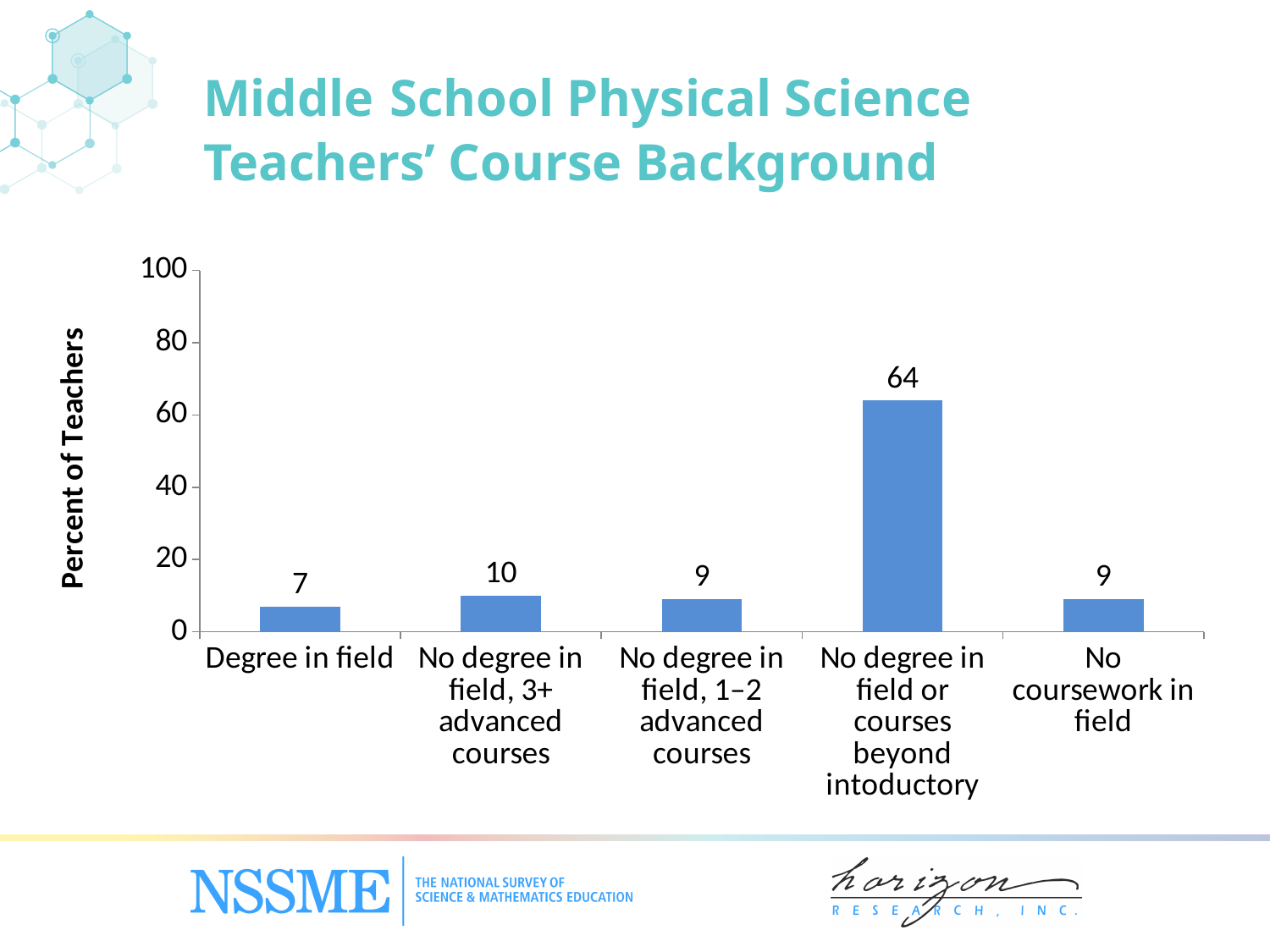
What kind of chart is shown on the slide? bar chart How many categories are shown on the x axis? 5 What is the value for 'No coursework in field'? 9 What is the difference between the value for 'No degree in field or courses beyond intoductory' and the value for 'Degree in field'? 57 Which category has the highest percent of teachers? No degree in field or courses beyond intoductory What is the value for 'No degree in field, 3+ advanced courses'? 10 What percent of teachers have a degree in field? 7 Is the value for 'No degree in field or courses beyond intoductory' greater or less than 60? greater What is the label of the y axis? Percent of Teachers What is the value for 'No degree in field or courses beyond intoductory'? 64 Which category has the lowest percent of teachers? Degree in field Which is larger: the value for 'No degree in field, 3+ advanced courses' or the value for 'Degree in field'? No degree in field, 3+ advanced courses